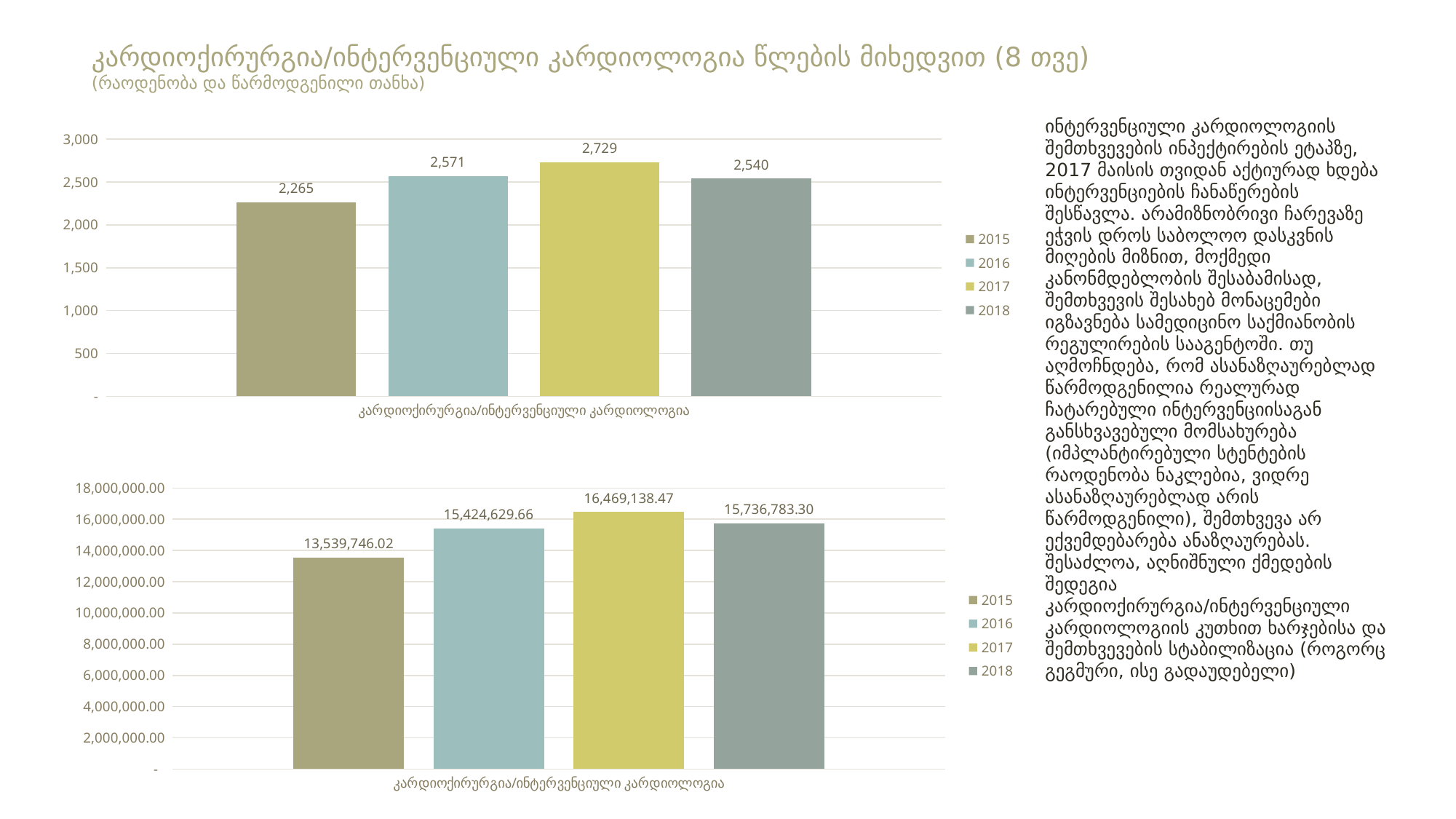
How many series does the legend of the bottom chart list? 4 In the top chart, what is the value for 2017? 2,729 What kind of chart is the top chart? bar chart In the bottom chart, which is larger, the value for 2017 or the value for 2018? 2017 In the top chart, which year has the highest value? 2017 In the top chart, what is the value for 2015? 2,265 In the top chart, which year has the lowest value? 2015 In the top chart, is the value for 2016 greater or less than 2,500? greater In the top chart, what is the difference between the 2017 and 2015 values? 464 In the bottom chart, what is the value for 2016? 15,424,629.66 In the bottom chart, which year has the lowest value? 2015 In the bottom chart, what is the value for 2018? 15,736,783.30